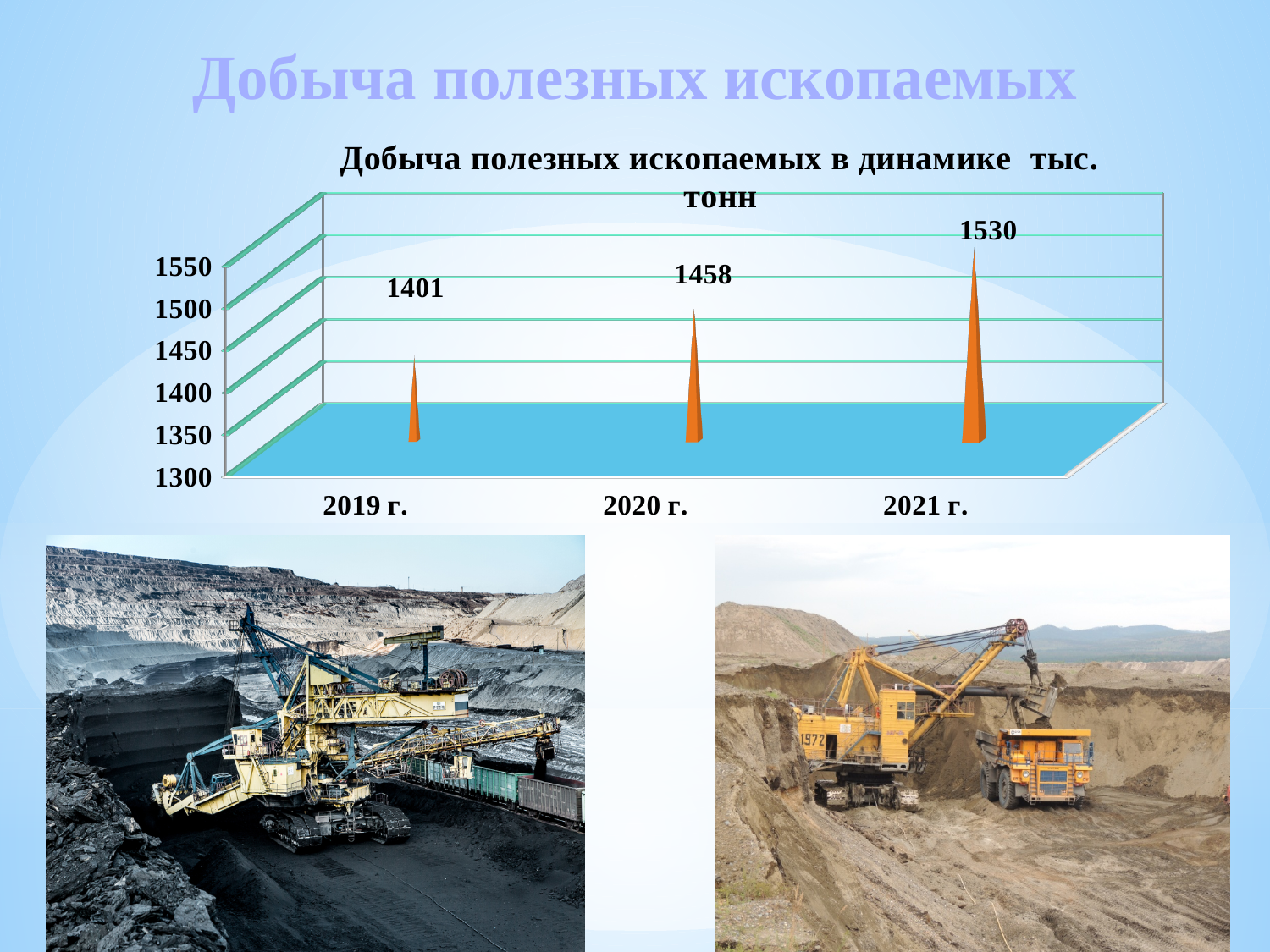
What is the difference between the values for 2021 г. and 2019 г.? 129 Is the value for 2021 г. greater or less than 1500? greater Do the values rise or fall from 2019 г. to 2021 г.? rise What is the value for 2019 г.? 1401 Which is larger, the value for 2020 г. or the value for 2021 г.? 2021 г. How many years are shown on the chart? 3 What is the title of the chart? Добыча полезных ископаемых в динамике тыс. тонн What is the value for 2020 г.? 1458 What is the difference between the values for 2020 г. and 2019 г.? 57 Which year has the highest value? 2021 г. Which year has the lowest value? 2019 г. What is the value for 2021 г.? 1530